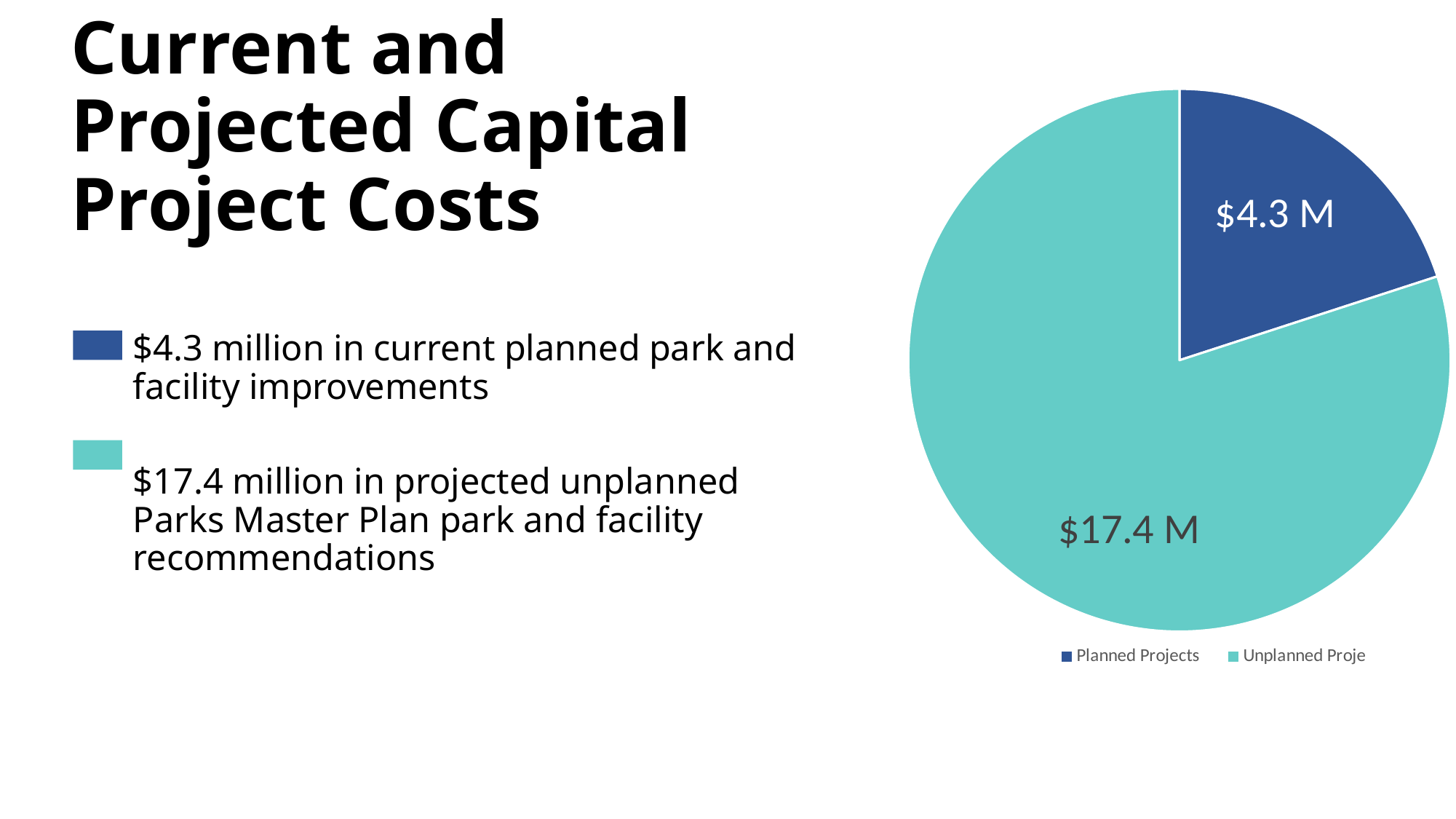
What colour is the Planned Projects slice in the pie chart? dark blue What is the combined total of the two slices in the pie chart? $21.7 M How much larger is the Unplanned Projects value than the Planned Projects value in the pie chart? $13.1 M What is the value of the Planned Projects slice in the pie chart? $4.3 M Which slice of the pie chart is the largest? Unplanned Projects What is the value of the Unplanned Projects slice in the pie chart? $17.4 M Which slice of the pie chart is the smallest? Planned Projects What type of chart is shown on the slide? pie chart What colour is the Unplanned Projects slice in the pie chart? teal Which is larger in the pie chart, Planned Projects or Unplanned Projects? Unplanned Projects How many entries does the pie chart legend list? 2 How many slices does the pie chart have? 2